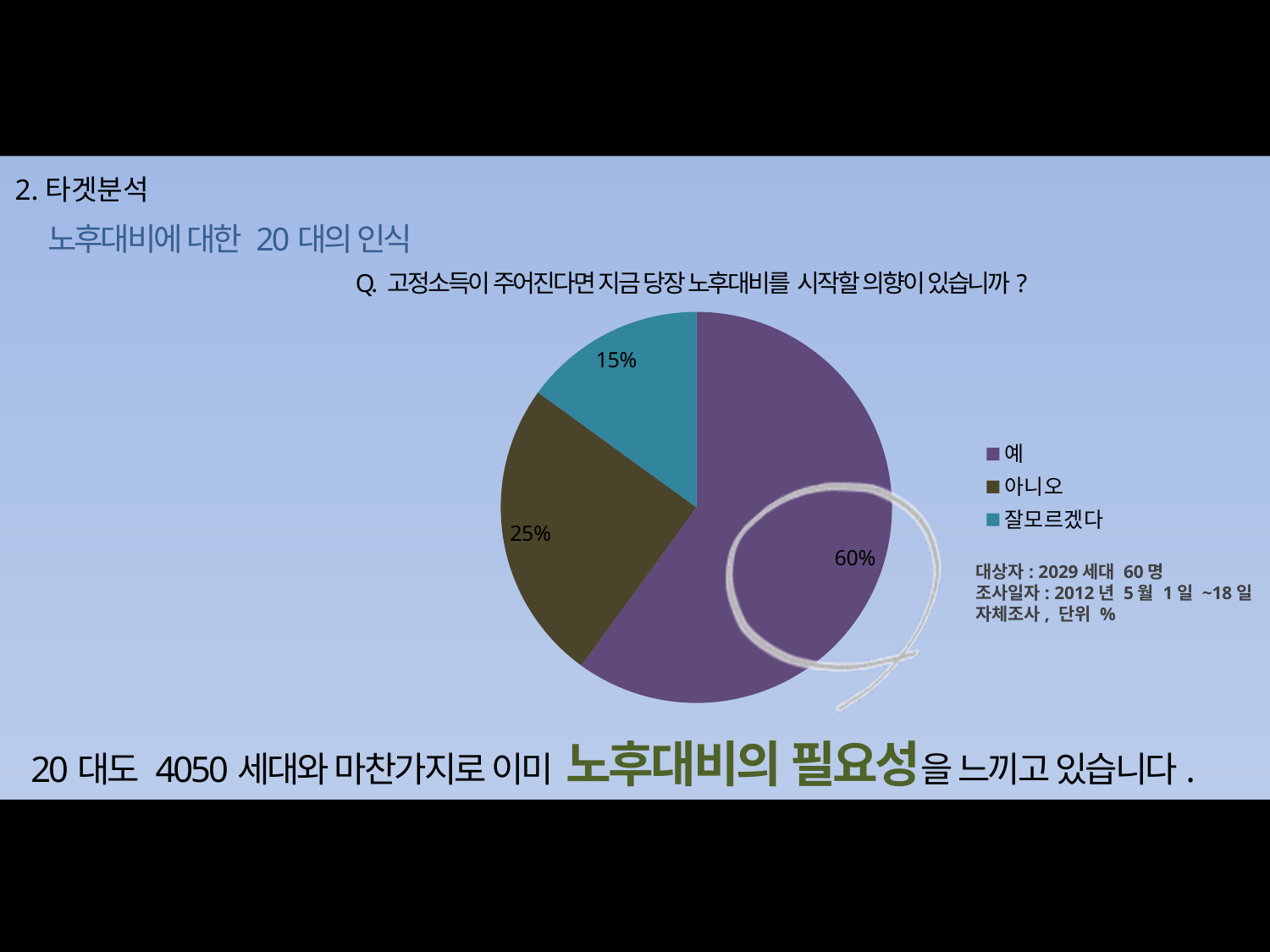
Which response has the largest share of the pie? 예 Which slice is larger, 아니오 or 잘모르겠다? 아니오 What percentage of respondents answered 아니오 (No)? 25% What is the difference in percentage points between the 예 and 아니오 slices? 35 What percentage of respondents answered 예 (Yes)? 60% Which response has the smallest share of the pie? 잘모르겠다 What colour is the 예 slice in the pie chart? purple How many entries does the legend list? 3 What kind of chart is shown on the slide? pie chart How many slices does the pie chart have? 3 What percentage of respondents answered 잘모르겠다 (Don't know)? 15% What is the combined share of the 아니오 and 잘모르겠다 slices? 40%